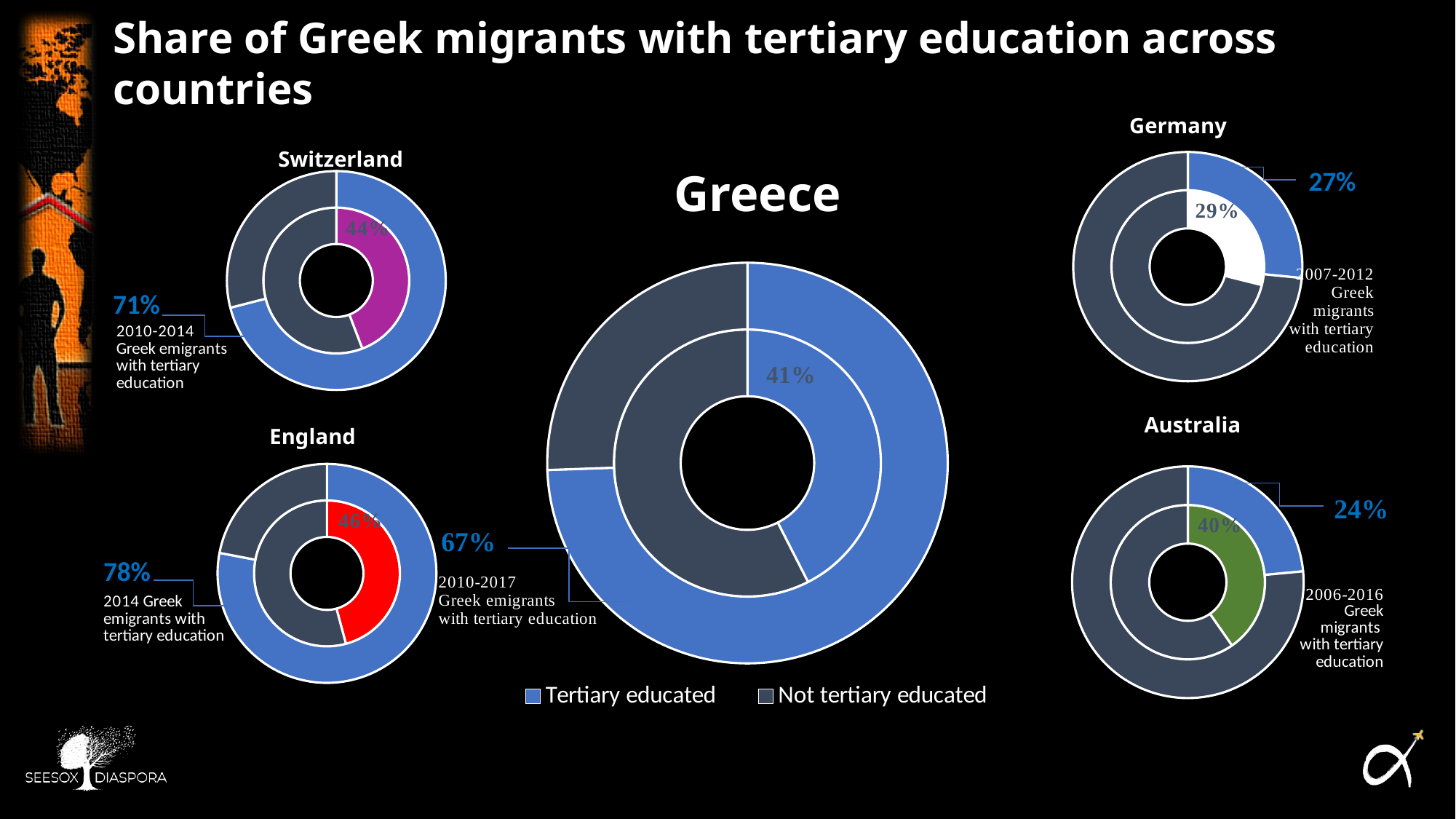
On the England chart, what share of 2014 Greek emigrants had tertiary education? 78% On the Greece chart, what share of 2010-2017 Greek emigrants had tertiary education? 67% What is the difference between the outer-ring tertiary education share for England (78%) and for Germany (27%)? 51 percentage points Which country's chart shows the lowest share of Greek migrants with tertiary education on its outer ring? Australia Which is larger: the outer-ring tertiary education share for Switzerland or for Greece? Switzerland What kind of chart is used for each country on this slide? Doughnut chart On the Germany chart, what share of 2007-2012 Greek migrants had tertiary education? 27% On the Greece chart, what value is printed on the inner ring? 41% Which country's chart shows the highest share of Greek emigrants with tertiary education on its outer ring? England On the Switzerland chart, what share of 2010-2014 Greek emigrants had tertiary education? 71% How many series does the legend list? 2 On the Australia chart, what share of 2006-2016 Greek migrants had tertiary education? 24%